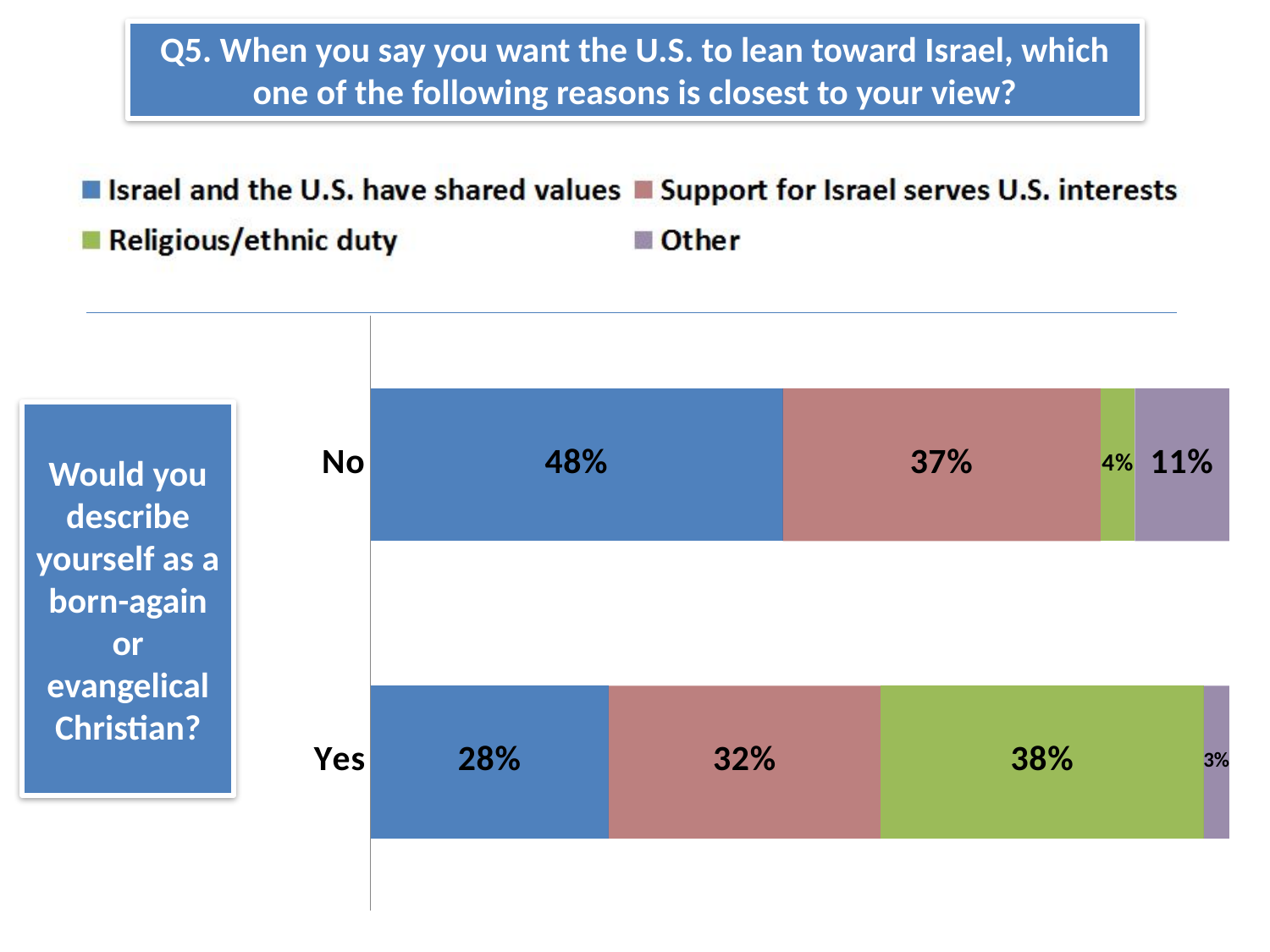
Which reason has the lowest share among the "No" group? Religious/ethnic duty What percentage of the "Yes" group chose "Support for Israel serves U.S. interests"? 32% How many series does the legend list? 4 What percentage of the "No" group chose "Israel and the U.S. have shared values"? 48% Which reason has the highest share among the "Yes" group? Religious/ethnic duty What percentage of the "No" group chose "Other"? 11% What is the total of the "Yes" bar? 101% What is the difference between the "No" and "Yes" groups for "Israel and the U.S. have shared values"? 20 percentage points What kind of chart is shown on the slide? Stacked bar chart Which group has a larger share for "Religious/ethnic duty", "Yes" or "No"? Yes How many categories (bars) are shown on the chart? 2 What percentage of the "Yes" group chose "Religious/ethnic duty"? 38%